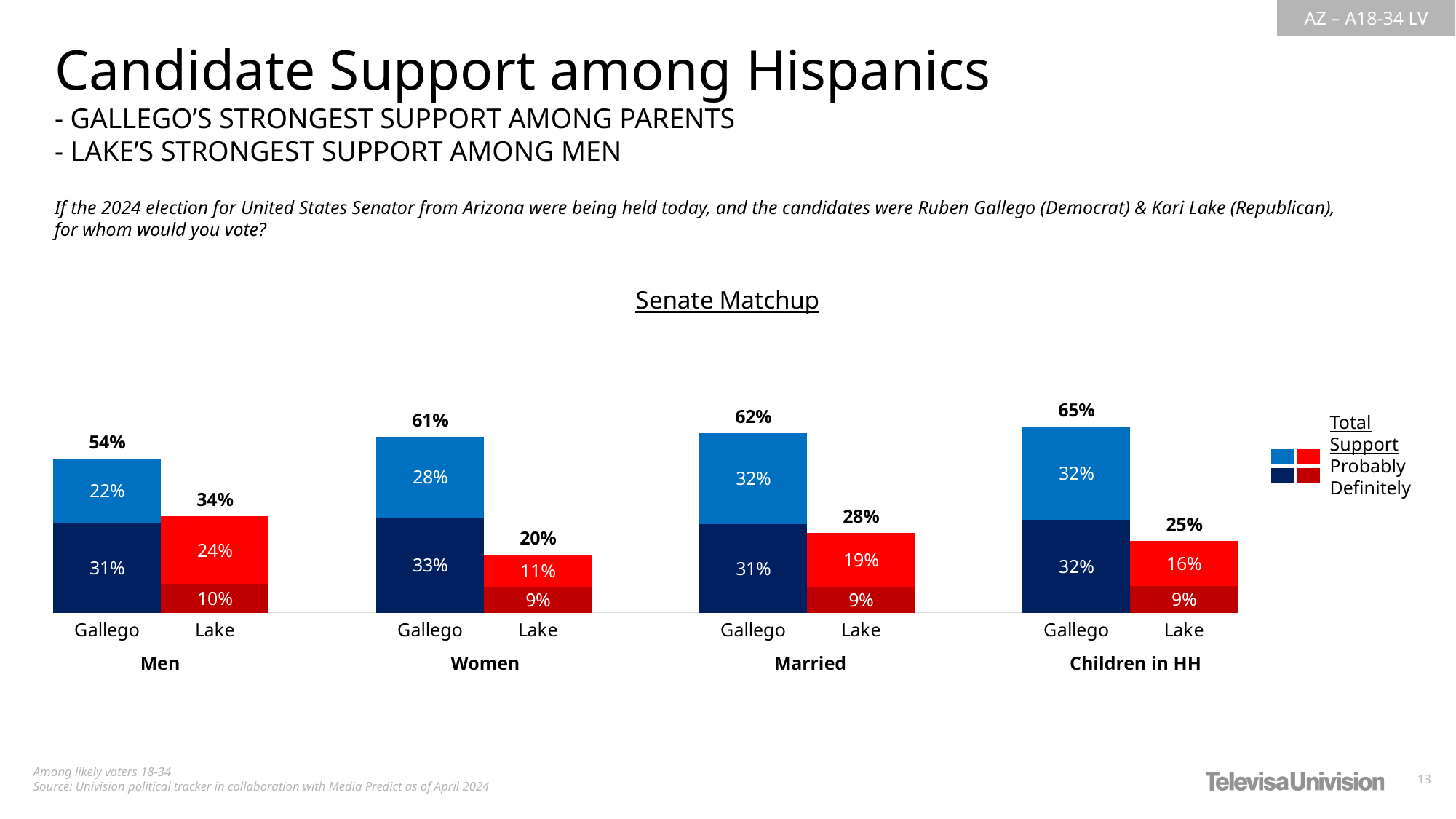
How many demographic groups are shown on the chart? 4 What share of Married voters say they would 'Definitely' vote for Gallego? 31% In which group is Lake's total support lowest? Women What is Lake's total support among Women? 20% What is the difference between Gallego's and Lake's total support among Married voters? 34 percentage points What is the total of the stacked bar for Lake among Men (Probably plus Definitely)? 34% What is the title of the chart? Senate Matchup What is Gallego's total support among Men? 54% What share of voters with Children in HH say they would 'Probably' vote for Lake? 16% What kind of chart is shown on the slide? Stacked bar chart In which group is Gallego's total support highest? Children in HH Among Men, who has higher total support, Gallego or Lake? Gallego